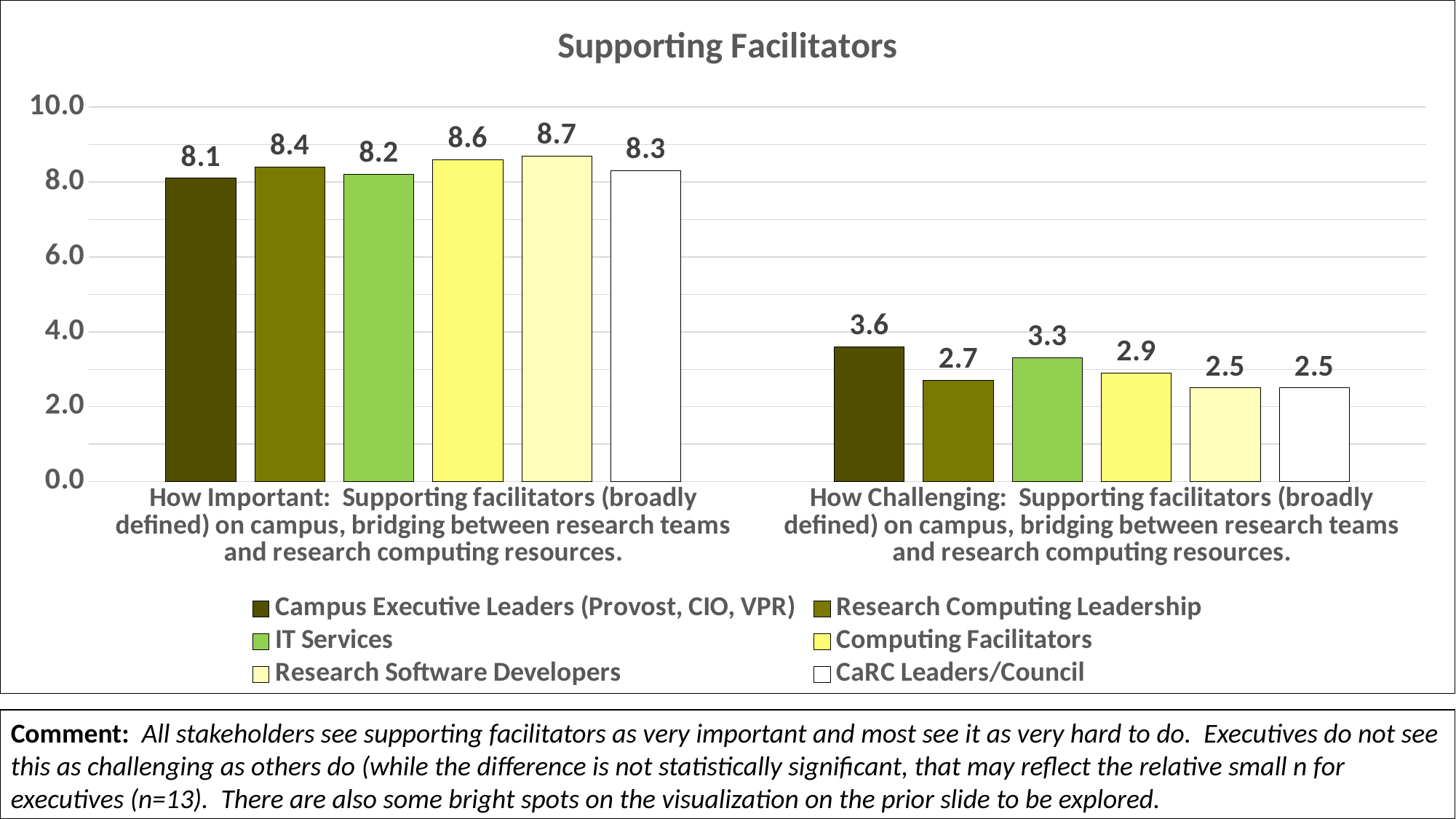
What is the difference between the Campus Executive Leaders and Research Computing Leadership values in the 'How Challenging' group? 0.9 In the 'How Challenging' group, is the value for Research Computing Leadership larger or smaller than the value for IT Services? smaller What is the chart's title? Supporting Facilitators Which series has the highest value in the 'How Challenging' group? Campus Executive Leaders (Provost, CIO, VPR) What is the difference between the Computing Facilitators values for 'How Important' and 'How Challenging'? 5.7 What is the value for IT Services in the 'How Challenging' group? 3.3 What kind of chart is shown on the slide? bar chart Which series has the lowest value in the 'How Important' group? Campus Executive Leaders (Provost, CIO, VPR) Which series has the highest value in the 'How Important' group? Research Software Developers How many series does the legend list? 6 What is the value for Research Software Developers in the 'How Challenging' group? 2.5 What is the value for Campus Executive Leaders (Provost, CIO, VPR) in the 'How Important' group? 8.1